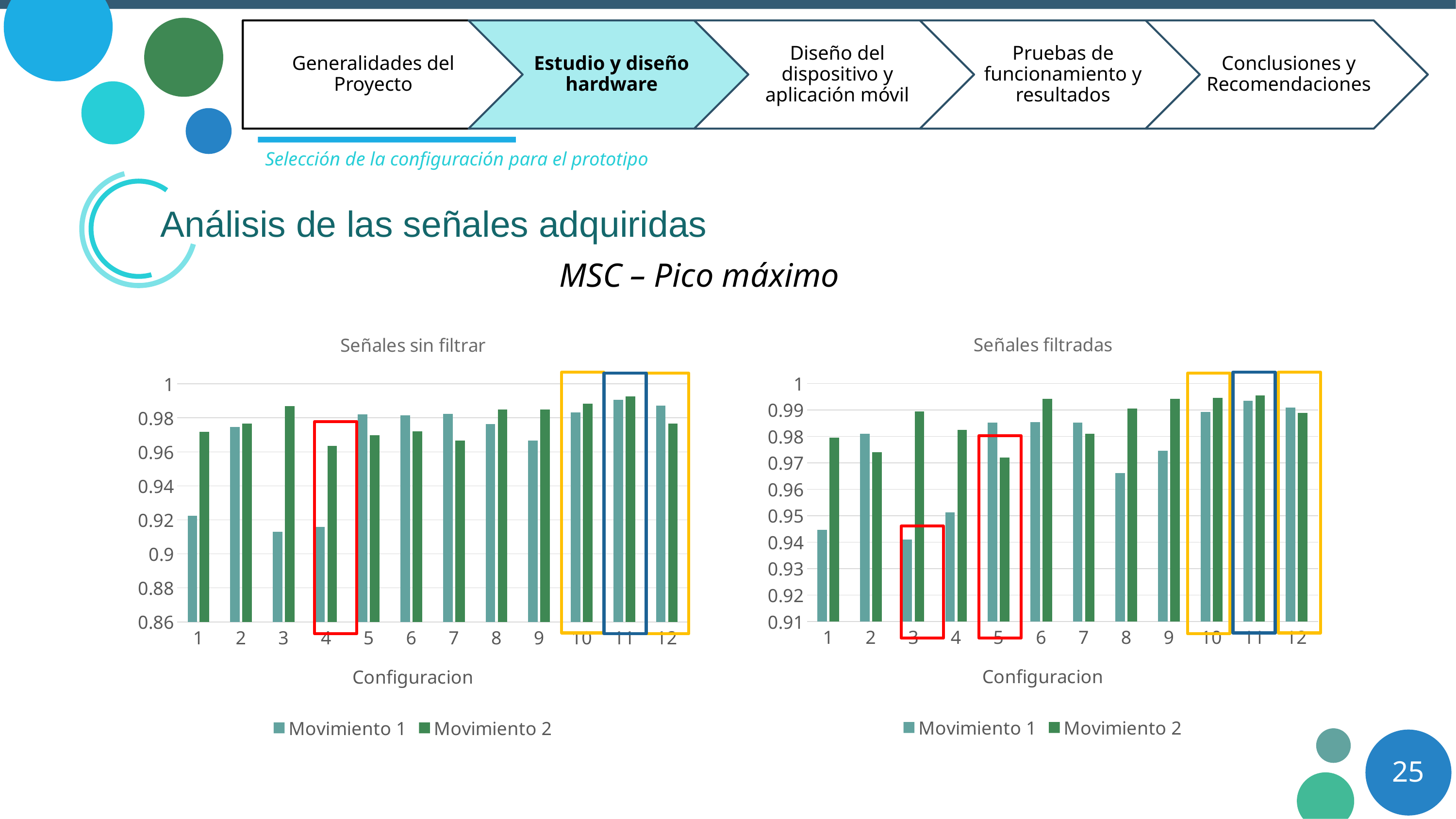
In the 'Señales filtradas' chart, is the value for Movimiento 2 at configuration 6 greater or less than 0.99? greater In the 'Señales sin filtrar' chart, at configuration 4, which series has the larger value, Movimiento 1 or Movimiento 2? Movimiento 2 What is the x-axis title of the 'Señales sin filtrar' chart? Configuracion In the 'Señales sin filtrar' chart, at configuration 9, which series has the larger value, Movimiento 1 or Movimiento 2? Movimiento 2 In the 'Señales sin filtrar' chart, is the value for Movimiento 2 at configuration 3 greater or less than 0.98? greater In the 'Señales sin filtrar' chart, is the value for Movimiento 1 at configuration 1 greater or less than 0.94? less In the 'Señales filtradas' chart, how many series does the legend list? 2 In the 'Señales filtradas' chart, at configuration 5, which series has the larger value, Movimiento 1 or Movimiento 2? Movimiento 1 What is the title of the chart on the right side of the slide? Señales filtradas What kind of chart is the 'Señales sin filtrar' chart? bar chart In the 'Señales sin filtrar' chart, how many configurations are shown on the x axis? 12